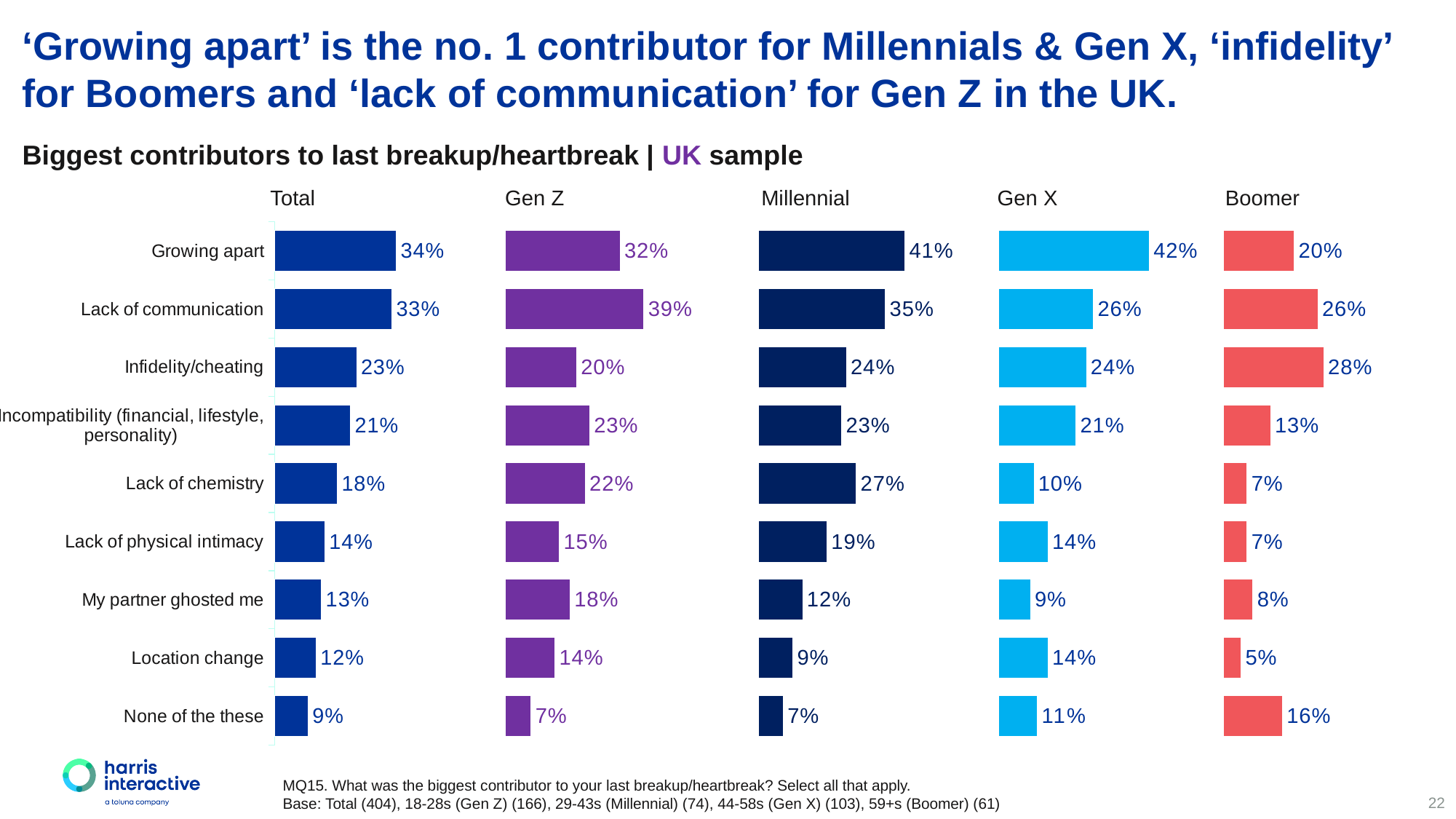
In the Gen Z chart, what is the value for Lack of communication? 39% In the Millennial chart, what is the difference between Growing apart and Lack of communication? 6% In the Boomer chart, what is the value for Infidelity/cheating? 28% In the Gen X chart, what is the value for Location change? 14% In the Gen X chart, which category has the highest value? Growing apart In the Millennial chart, which is larger: Lack of chemistry or Infidelity/cheating? Lack of chemistry In the Total chart, what is the value for Growing apart? 34% How many categories are shown in the Gen Z chart? 9 In the Boomer chart, what is the difference between Lack of communication and Growing apart? 6% How many separate bar charts are shown on the slide? 5 In the Millennial chart, which category has the lowest value? None of the these What kind of chart is the Total chart? Bar chart